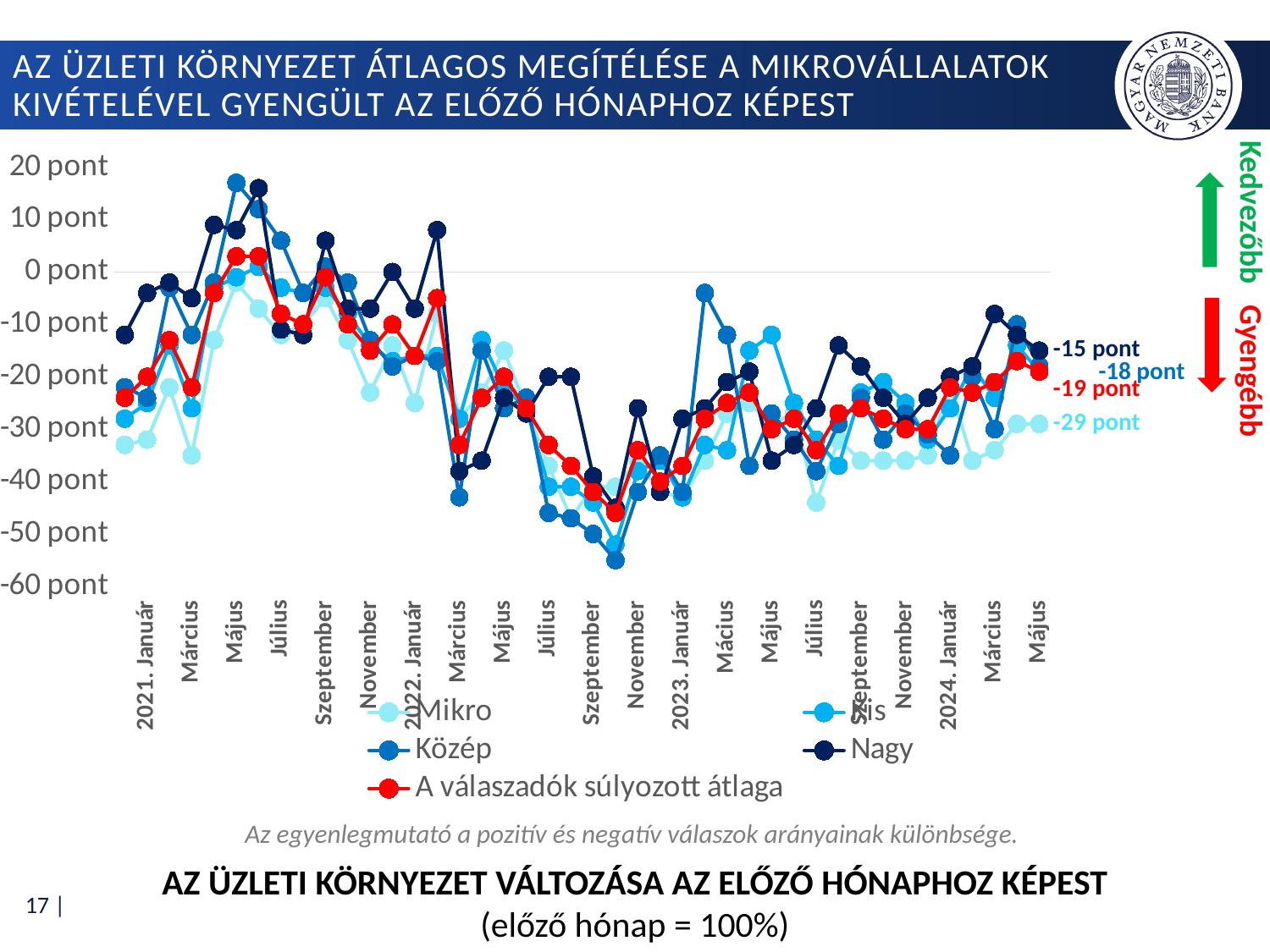
Which series is drawn in red in the legend? A válaszadók súlyozott átlaga What is the difference between the end-of-series labels for Nagy (-15 pont) and Mikro (-29 pont)? 14 pont What is the value labelled at the end of the 'A válaszadók súlyozott átlaga' series (Május 2024)? -19 pont What is the value labelled at the end of the Nagy series (Május 2024)? -15 pont What type of chart is shown on the slide? line chart Does the 'A válaszadók súlyozott átlaga' series rise or fall between Május 2021 and Szeptember 2022? fall Is the value for Mikro in Március 2021 greater or less than -30 pont? less Among the four values labelled at the right end of the chart, which is the lowest? -29 pont What is the value labelled at the end of the Mikro series (Május 2024)? -29 pont Is the value for Közép in Május 2021 greater or less than 10 pont? greater At Május 2024, which series has the higher value: Nagy or Mikro? Nagy How many series does the legend list? 5